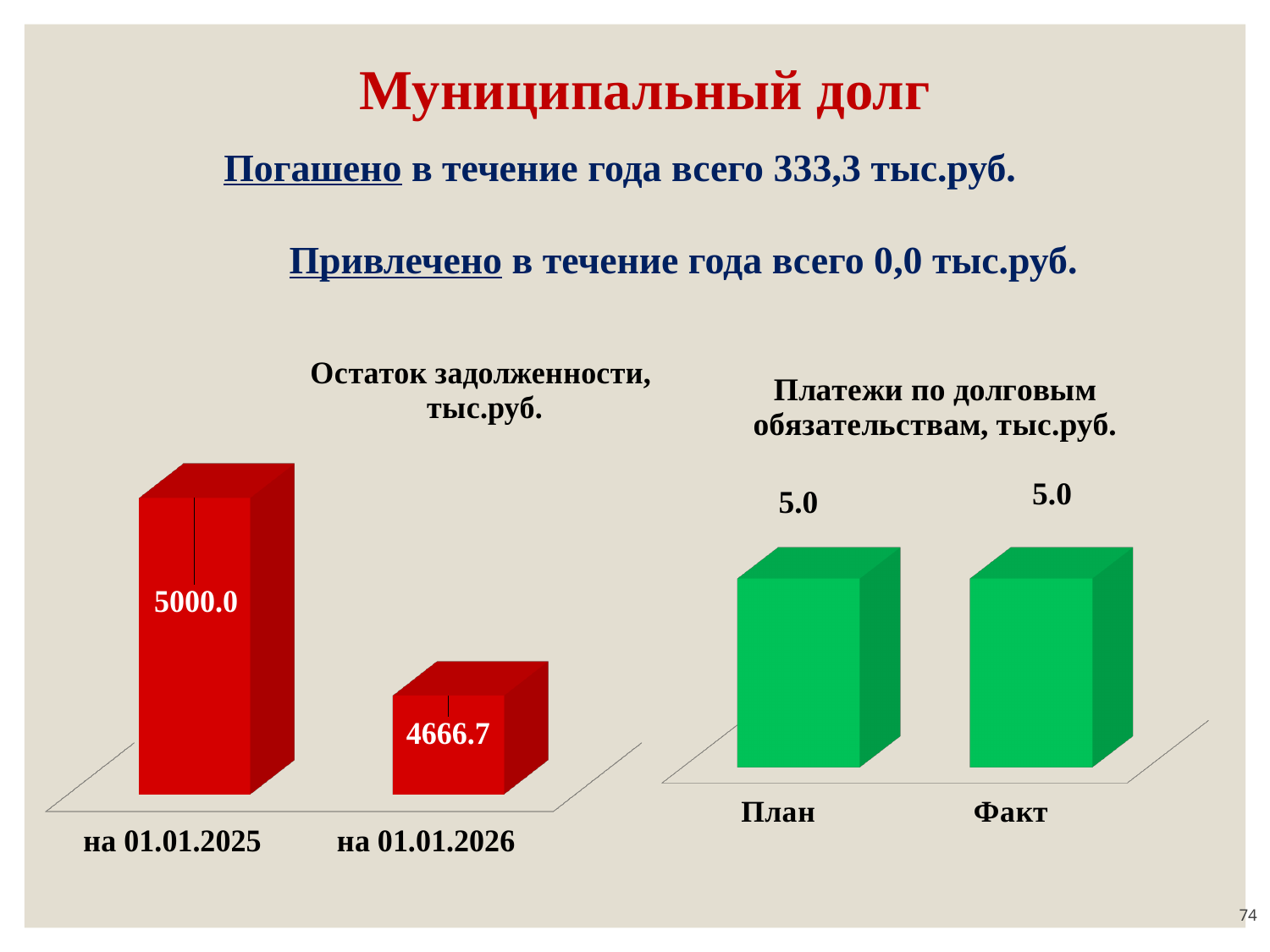
In the chart 'Остаток задолженности, тыс.руб.', do the values rise or fall from 'на 01.01.2025' to 'на 01.01.2026'? fall In the chart 'Платежи по долговым обязательствам, тыс.руб.', what is the value for 'План'? 5.0 In the chart 'Остаток задолженности, тыс.руб.', what is the value for 'на 01.01.2026'? 4666.7 In the chart 'Платежи по долговым обязательствам, тыс.руб.', what is the difference between the values for 'План' and 'Факт'? 0.0 In the chart 'Остаток задолженности, тыс.руб.', what is the difference between the values for 'на 01.01.2025' and 'на 01.01.2026'? 333.3 What kind of chart is 'Платежи по долговым обязательствам, тыс.руб.'? bar chart In the chart 'Платежи по долговым обязательствам, тыс.руб.', what is the value for 'Факт'? 5.0 In the chart 'Остаток задолженности, тыс.руб.', what is the value for 'на 01.01.2025'? 5000.0 In the chart 'Остаток задолженности, тыс.руб.', which category has the highest value? на 01.01.2025 What colour are the bars in the chart 'Остаток задолженности, тыс.руб.'? red In the chart 'Остаток задолженности, тыс.руб.', which category has the lowest value? на 01.01.2026 In the chart 'Остаток задолженности, тыс.руб.', how many categories are shown? 2